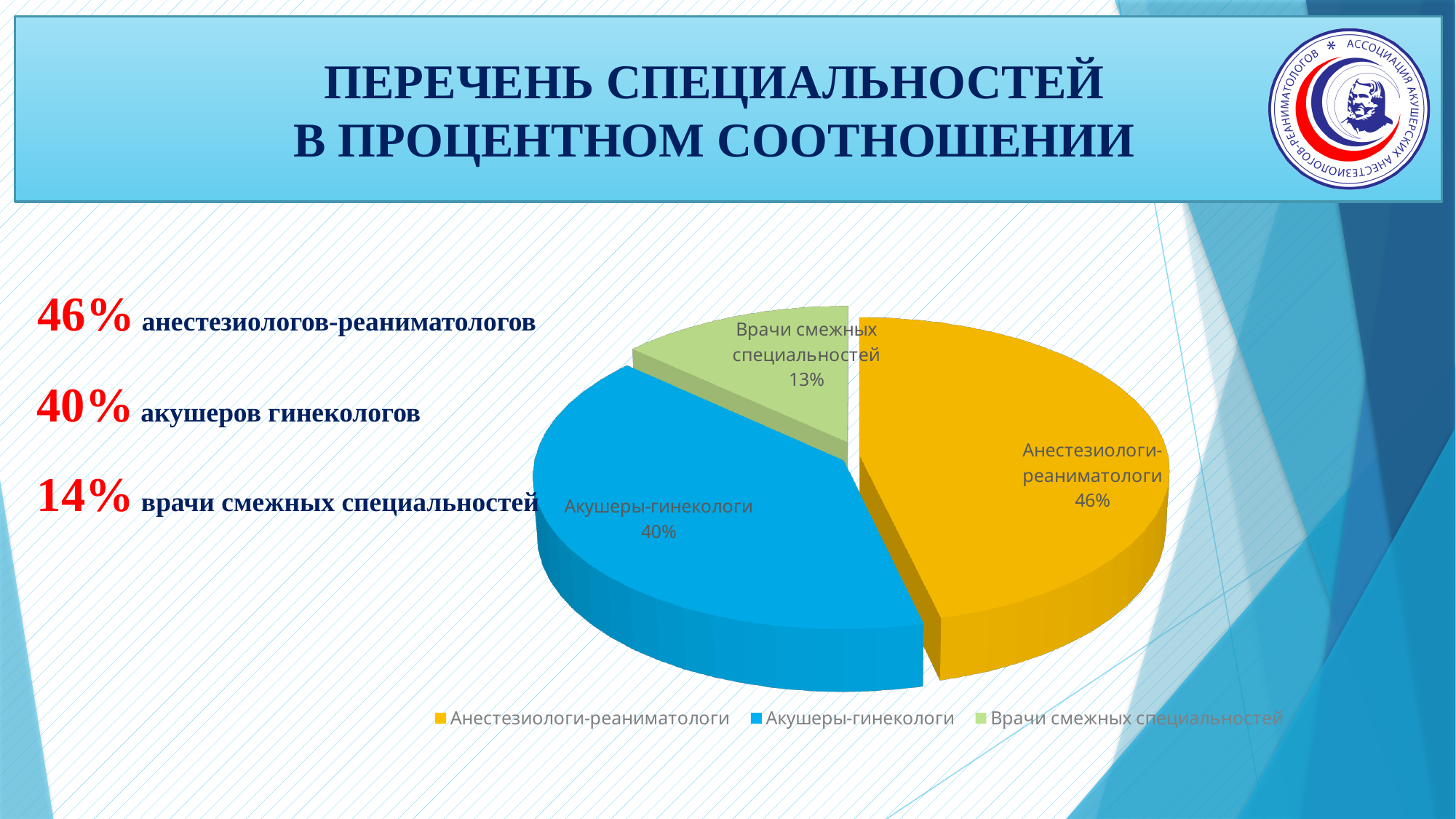
What is the difference in percentage points between Анестезиологи-реаниматологи and Акушеры-гинекологи? 6 What kind of chart is shown on the slide? Pie chart What percentage does the chart show for Акушеры-гинекологи? 40% What percentage does the chart show for Анестезиологи-реаниматологи? 46% How many slices does the pie chart have? 3 Which category has the largest slice in the pie chart? Анестезиологи-реаниматологи What is the difference in percentage points between Акушеры-гинекологи and Врачи смежных специальностей? 27 How many entries does the chart legend list? 3 Which category has the smallest slice in the pie chart? Врачи смежных специальностей What colour is the slice for Акушеры-гинекологи? Blue What percentage does the chart show for Врачи смежных специальностей? 13% Which slice is larger: Акушеры-гинекологи or Врачи смежных специальностей? Акушеры-гинекологи